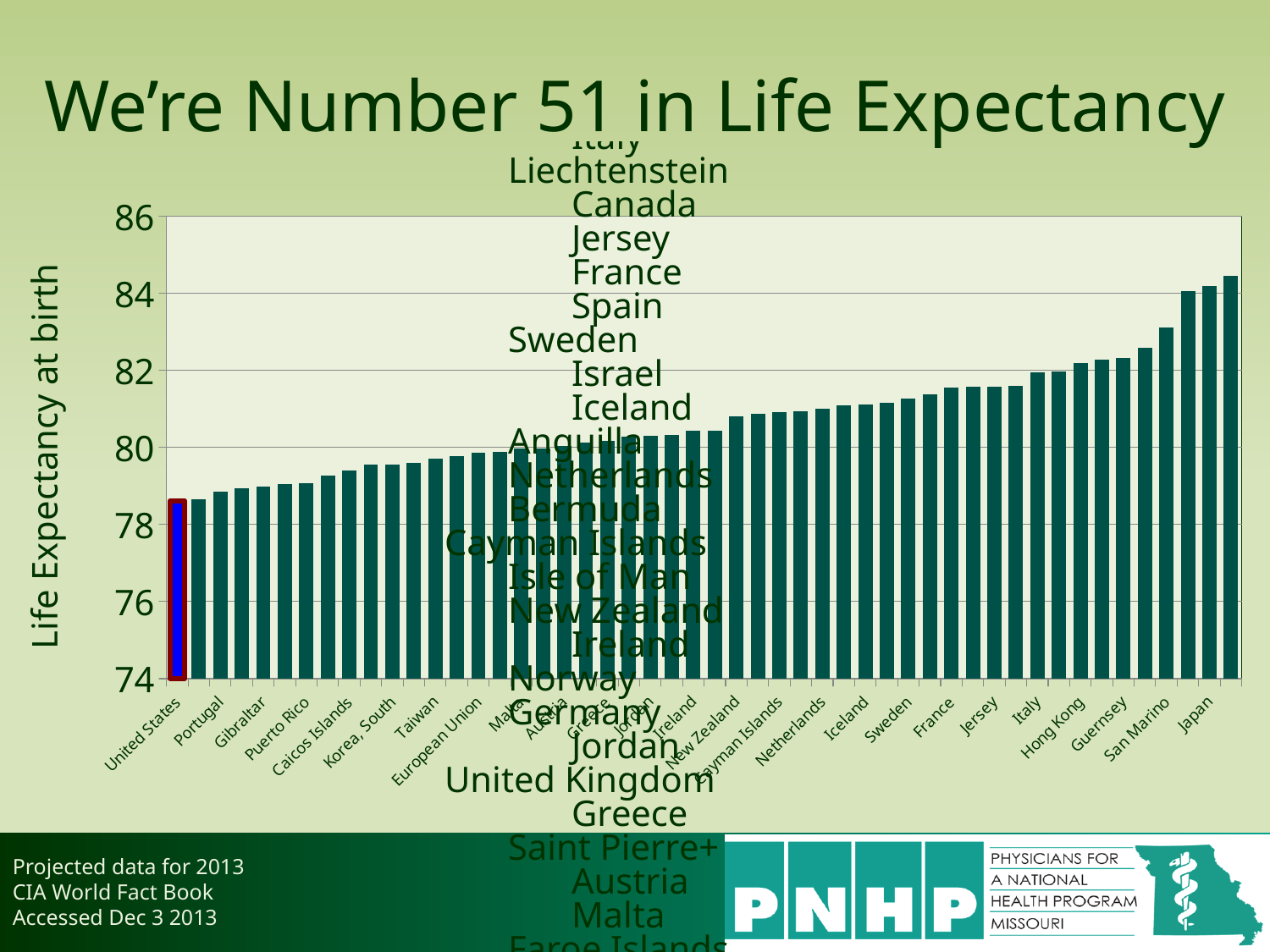
Is the value for San Marino greater or less than 84? less Is the value for Japan greater or less than 84? greater Is the value for United States greater or less than 80? less Which country has the lowest life expectancy in the chart? United States What kind of chart is shown on the slide? bar chart Which has a higher life expectancy, Japan or Portugal? Japan Do the bar values rise or fall from left to right along the x axis? rise What is the label on the vertical axis of the chart? Life Expectancy at birth